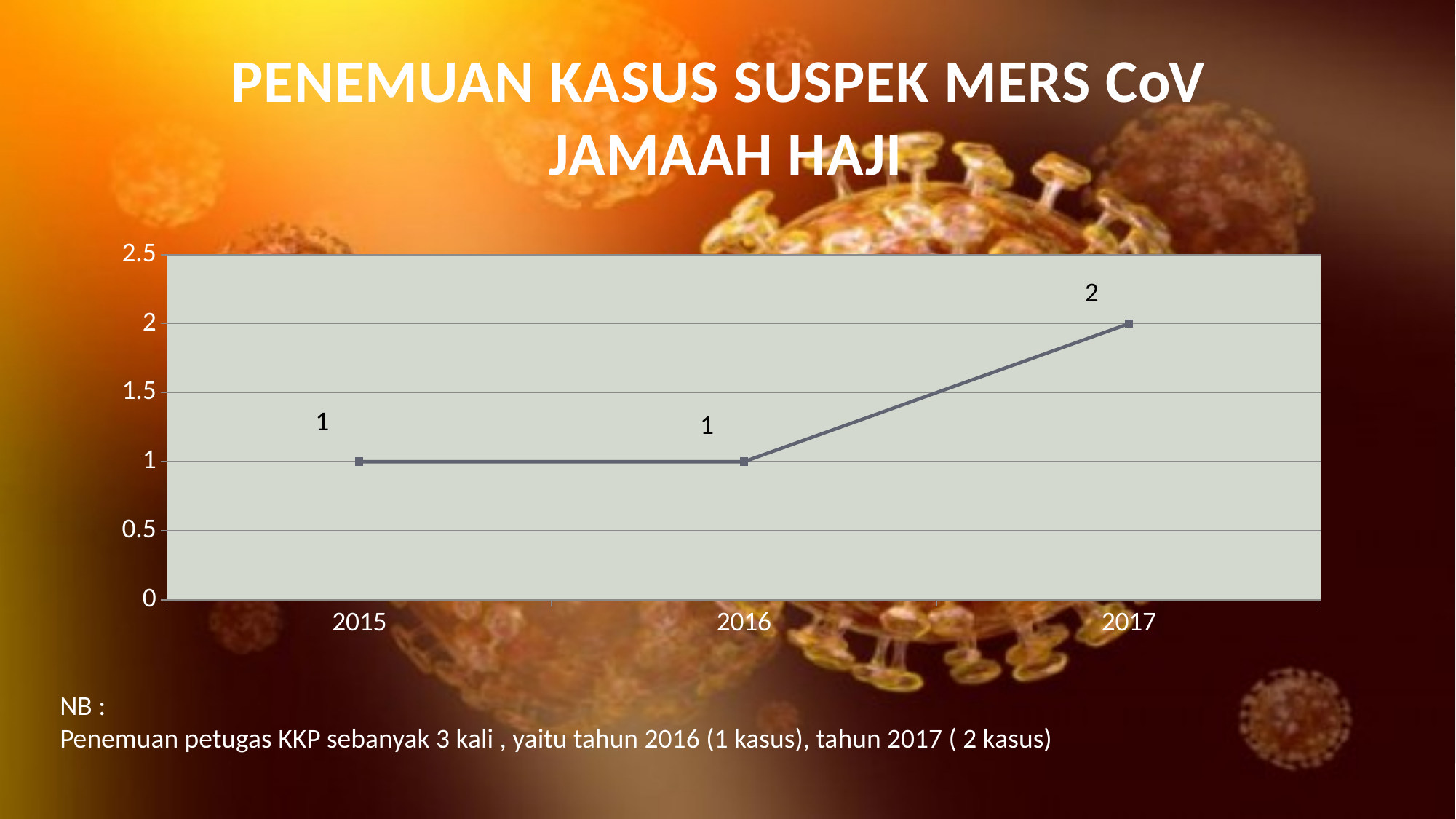
What is the value for 2015? 1 Which year has the highest value? 2017 Do the values rise or fall from 2016 to 2017? rise Is the value for 2015 greater or less than 1.5? less What is the difference between the values for 2017 and 2016? 1 What kind of chart is shown on the slide? line chart Is the value for 2017 greater or less than 1.5? greater What is the value for 2017? 2 Which is larger, the value for 2017 or the value for 2015? 2017 How many years are plotted on the chart? 3 What is the value for 2016? 1 What is the title of the slide containing the chart? PENEMUAN KASUS SUSPEK MERS CoV JAMAAH HAJI